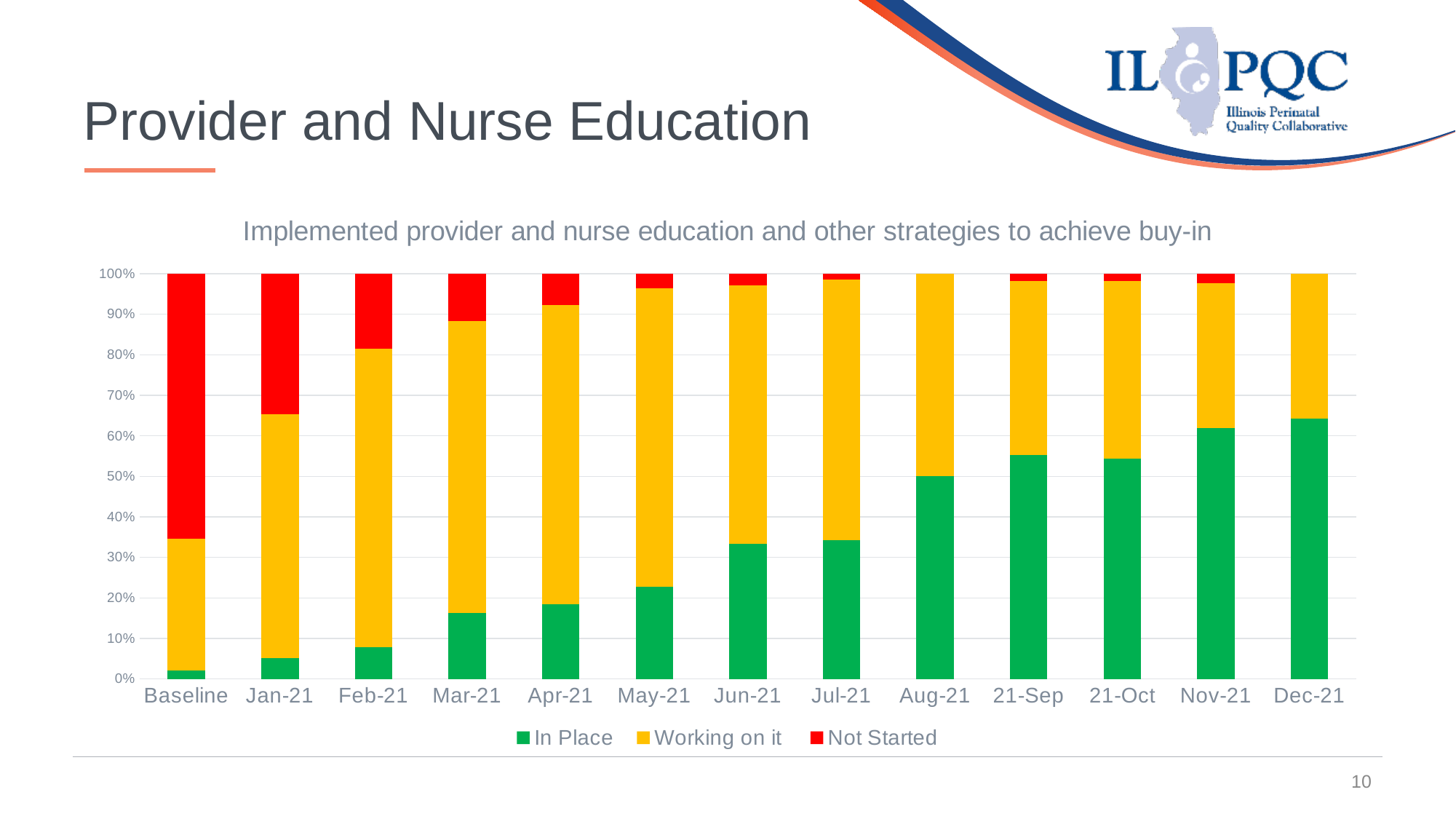
How many series does the legend list? 3 Which has a larger 'In Place' share, Jul-21 or Jan-21? Jul-21 Which category has the largest 'Not Started' share? Baseline Is the 'In Place' value for Jun-21 greater or less than 40%? less Which category has the smallest 'In Place' share? Baseline What is the title of the chart? Implemented provider and nurse education and other strategies to achieve buy-in Is the 'In Place' value for Dec-21 greater or less than 60%? greater How many categories are shown along the x axis? 13 Is the 'In Place' value for Baseline greater or less than 10%? less Which colour represents the 'Not Started' series? Red What kind of chart is shown on the slide? Stacked bar chart Does the 'In Place' share generally rise or fall from Baseline to Dec-21? Rise